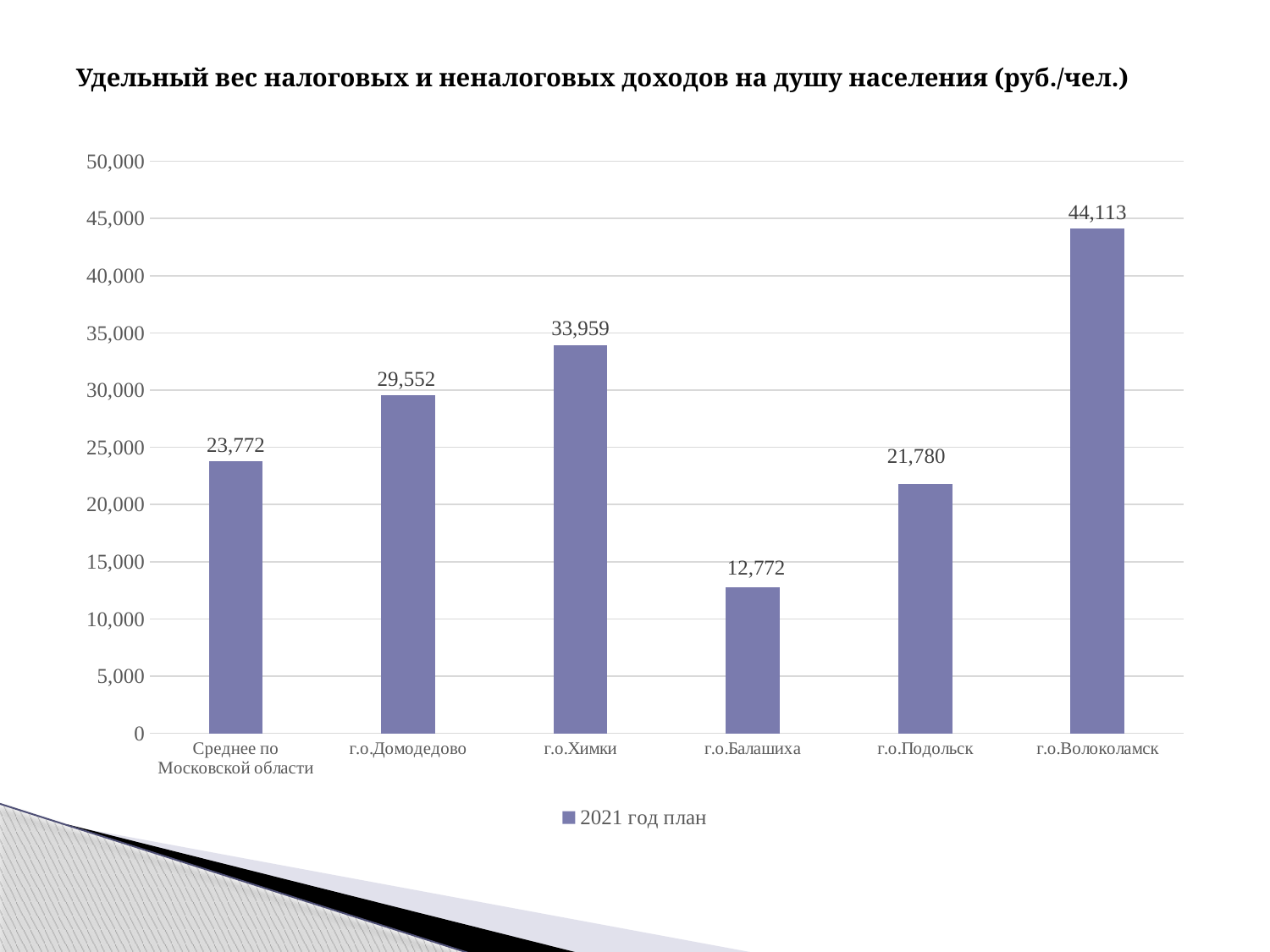
How many categories are shown on the x axis? 6 Which category has the highest value? г.о.Волоколамск Which is larger, the value for г.о.Химки or the value for г.о.Подольск? г.о.Химки What is the value for г.о.Домодедово? 29,552 What kind of chart is shown on the slide? bar chart Which category has the lowest value? г.о.Балашиха What is the value for г.о.Балашиха? 12,772 What is the difference between the values for г.о.Домодедово and г.о.Подольск? 7,772 What is the difference between the values for г.о.Волоколамск and г.о.Химки? 10,154 What is the value for Среднее по Московской области? 23,772 Is the value for г.о.Подольск greater or less than 25,000? less How many series does the legend list? 1